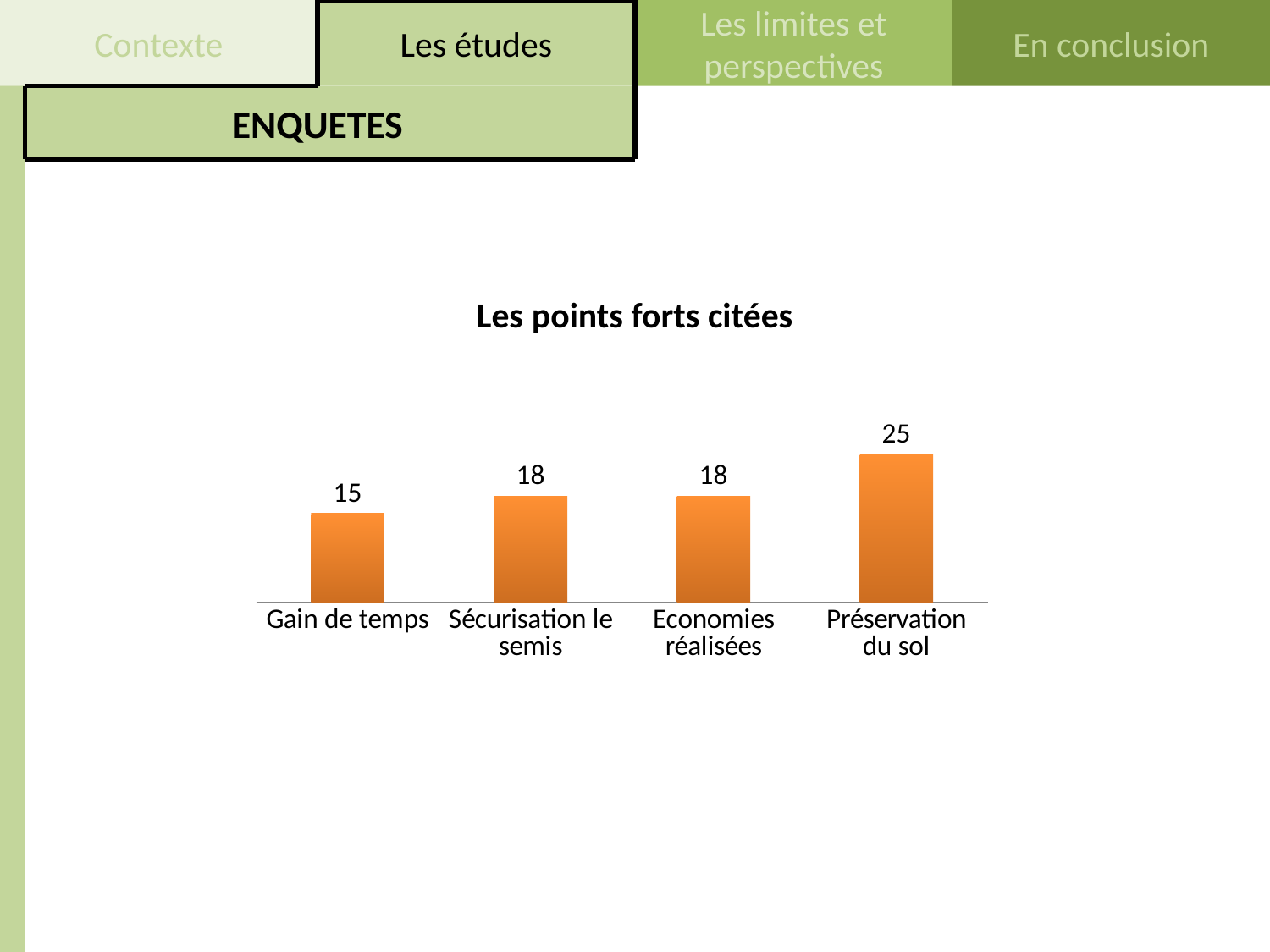
What is the value for Economies réalisées? 18 What is the value for Gain de temps? 15 What is the value for Sécurisation le semis? 18 What is the value for Préservation du sol? 25 Which category has the highest value? Préservation du sol Which is larger, the value for Préservation du sol or the value for Economies réalisées? Préservation du sol How many categories are shown in the chart? 4 What is the difference between the values for Sécurisation le semis and Gain de temps? 3 Which category has the lowest value? Gain de temps What is the difference between the values for Préservation du sol and Gain de temps? 10 What kind of chart is shown on the slide? Bar chart What is the title of the chart? Les points forts citées